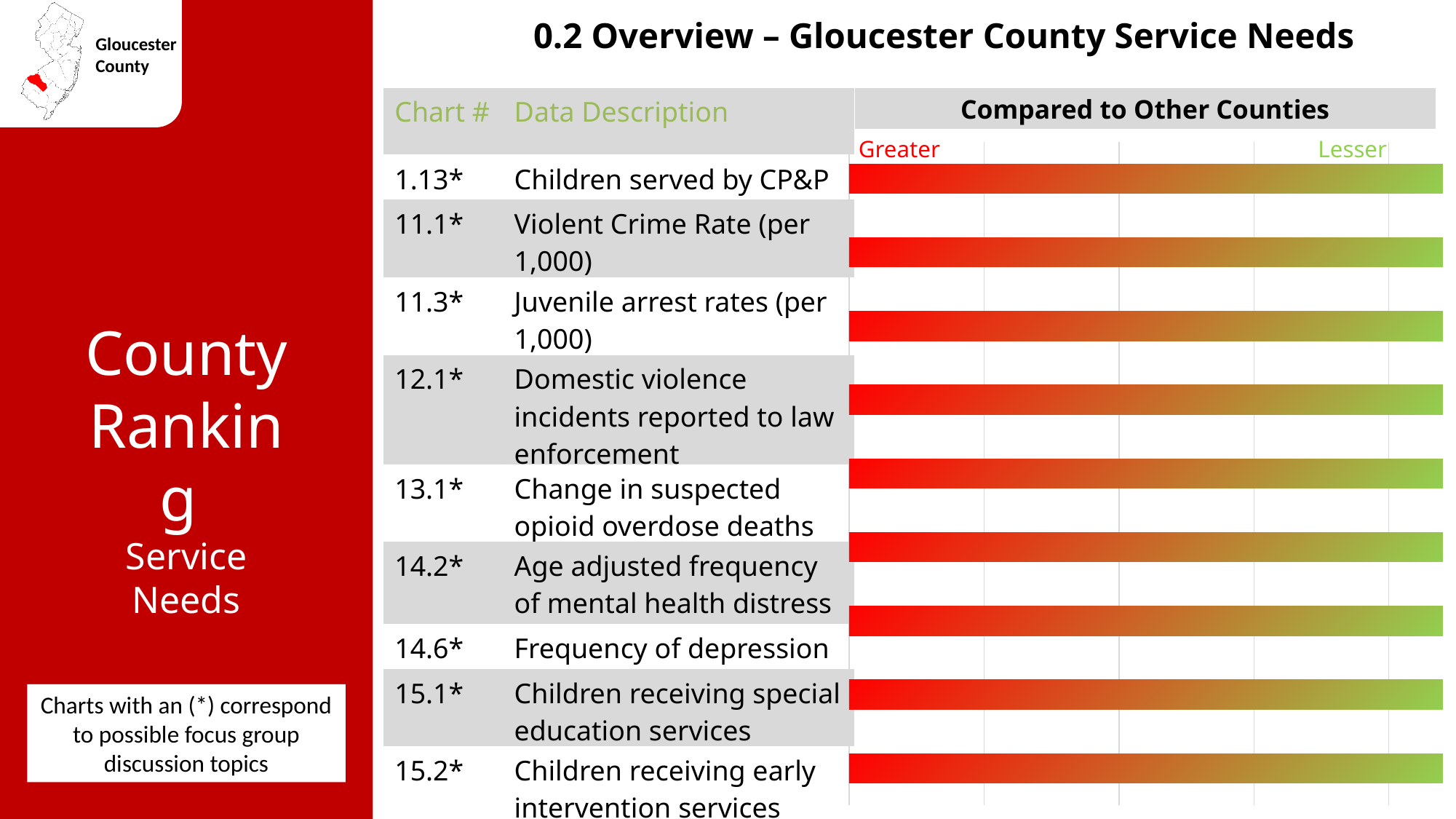
What is the title of the chart column on the right of the table? Compared to Other Counties Which data description is listed for chart number 13.1*? Change in suspected opioid overdose deaths How many data descriptions (rows) are plotted in the chart? 9 What kind of chart is shown under 'Compared to Other Counties'? bar chart Which chart number is listed for 'Frequency of depression'? 14.6* Which data description is listed for chart number 1.13*? Children served by CP&P What label appears at the left end of the chart's scale, and what label appears at the right end? Greater (left), Lesser (right)